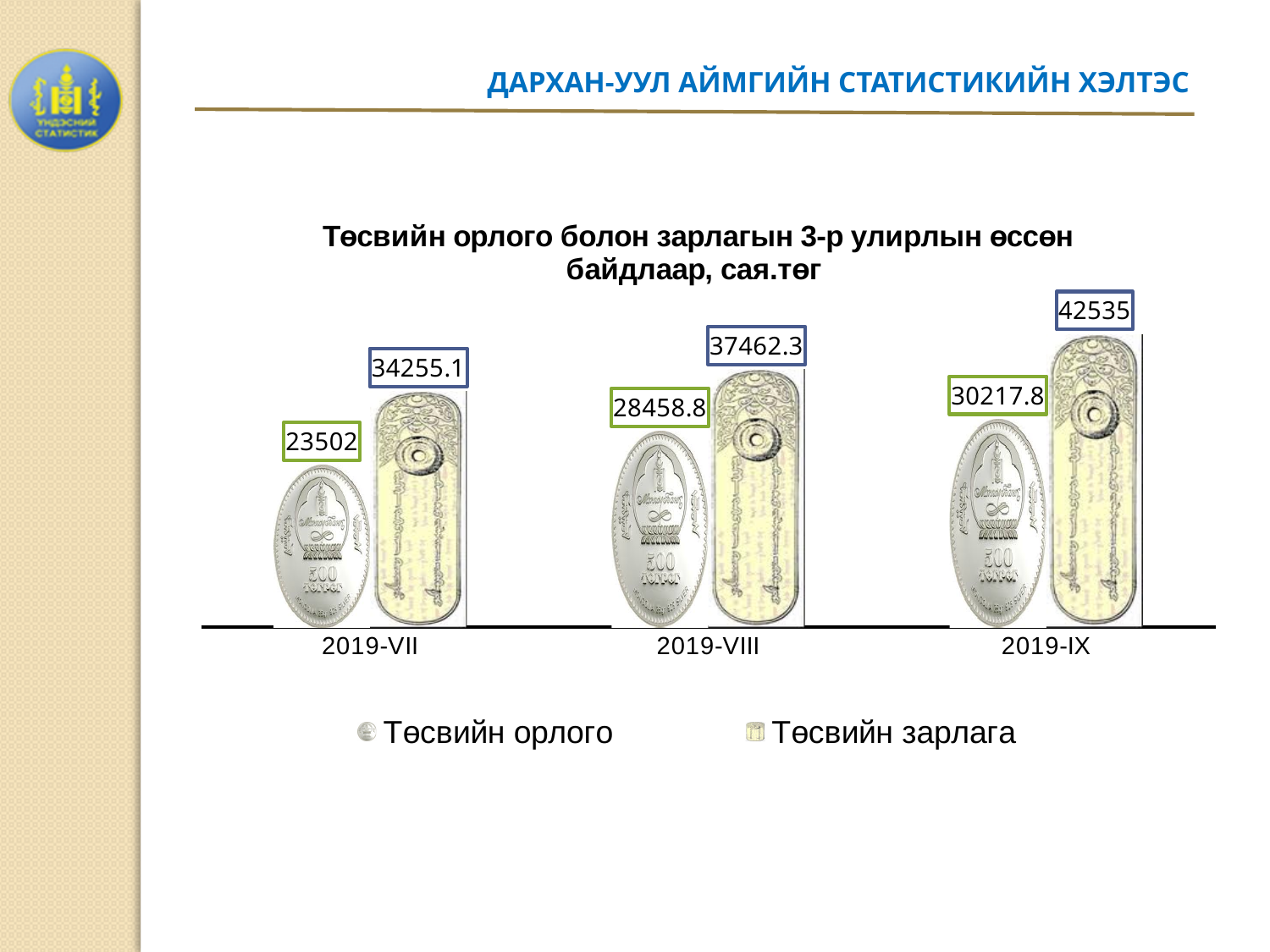
Which is larger in 2019-VIII, Төсвийн орлого or Төсвийн зарлага? Төсвийн зарлага What is the value of Төсвийн орлого for 2019-VII? 23502 What is the value of Төсвийн орлого for 2019-IX? 30217.8 What is the difference between Төсвийн зарлага and Төсвийн орлого in 2019-VII? 10753.1 How many periods are shown on the x axis? 3 What is the value of Төсвийн зарлага for 2019-IX? 42535 How many series does the legend list? 2 What is the value of Төсвийн зарлага for 2019-VIII? 37462.3 In which period is Төсвийн орлого lowest? 2019-VII Do the values of Төсвийн орлого rise or fall from 2019-VII to 2019-IX? Rise In which period is Төсвийн зарлага highest? 2019-IX What kind of chart is shown on the slide? Bar chart